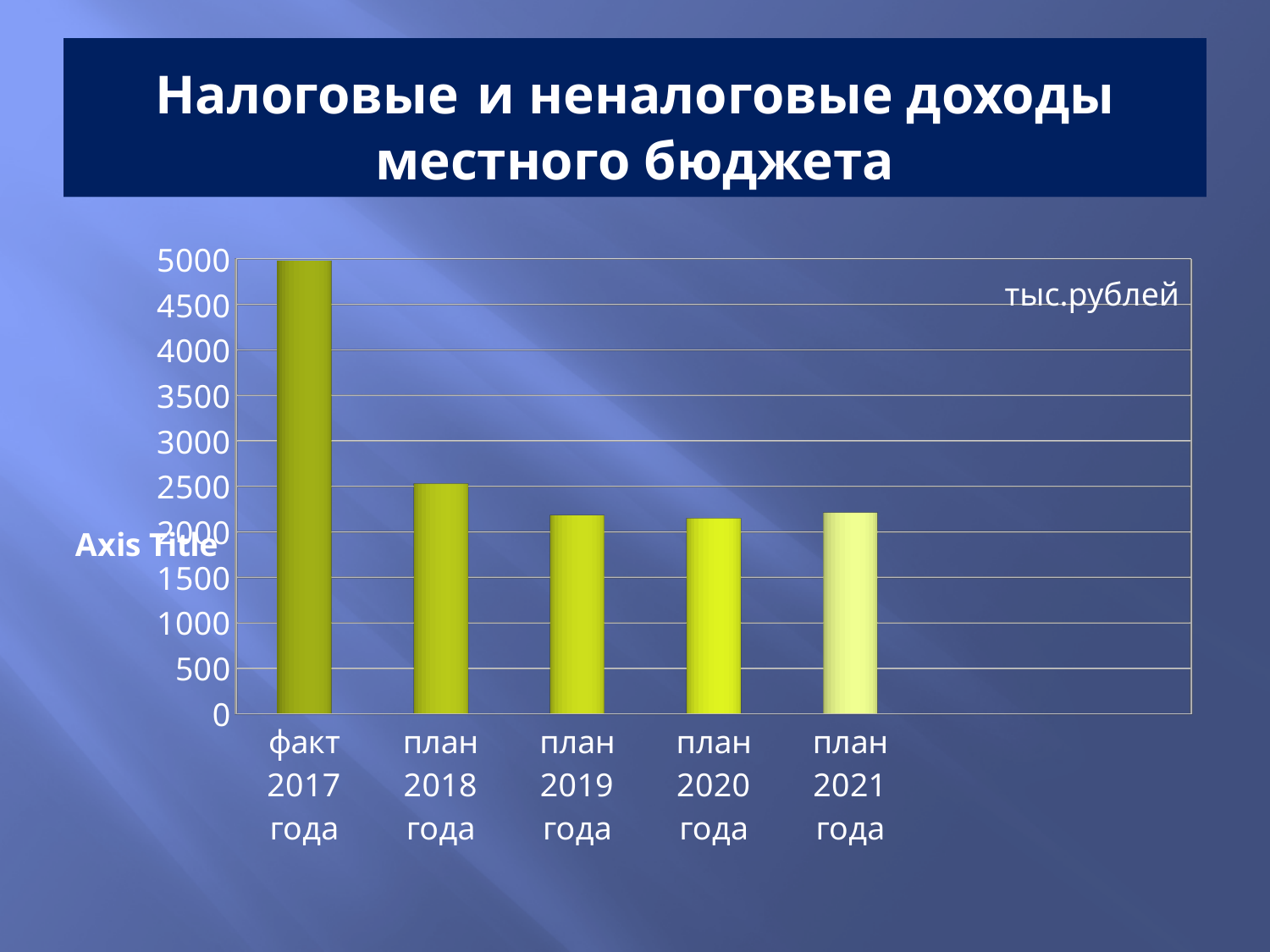
Is the value for план 2018 года greater or less than 3000? less Is the value for план 2019 года greater or less than 2000? greater How many bars (categories) are plotted in the chart? 5 Which is larger: the value for факт 2017 года or the value for план 2018 года? факт 2017 года Is the value for план 2021 года greater or less than 2000? greater What unit label is shown in the upper right of the chart area? тыс.рублей Which is larger: the value for план 2018 года or the value for план 2021 года? план 2018 года From факт 2017 года to план 2020 года, do the values rise or fall? fall Which category has the highest value in the chart? факт 2017 года What kind of chart is shown on the slide? bar chart